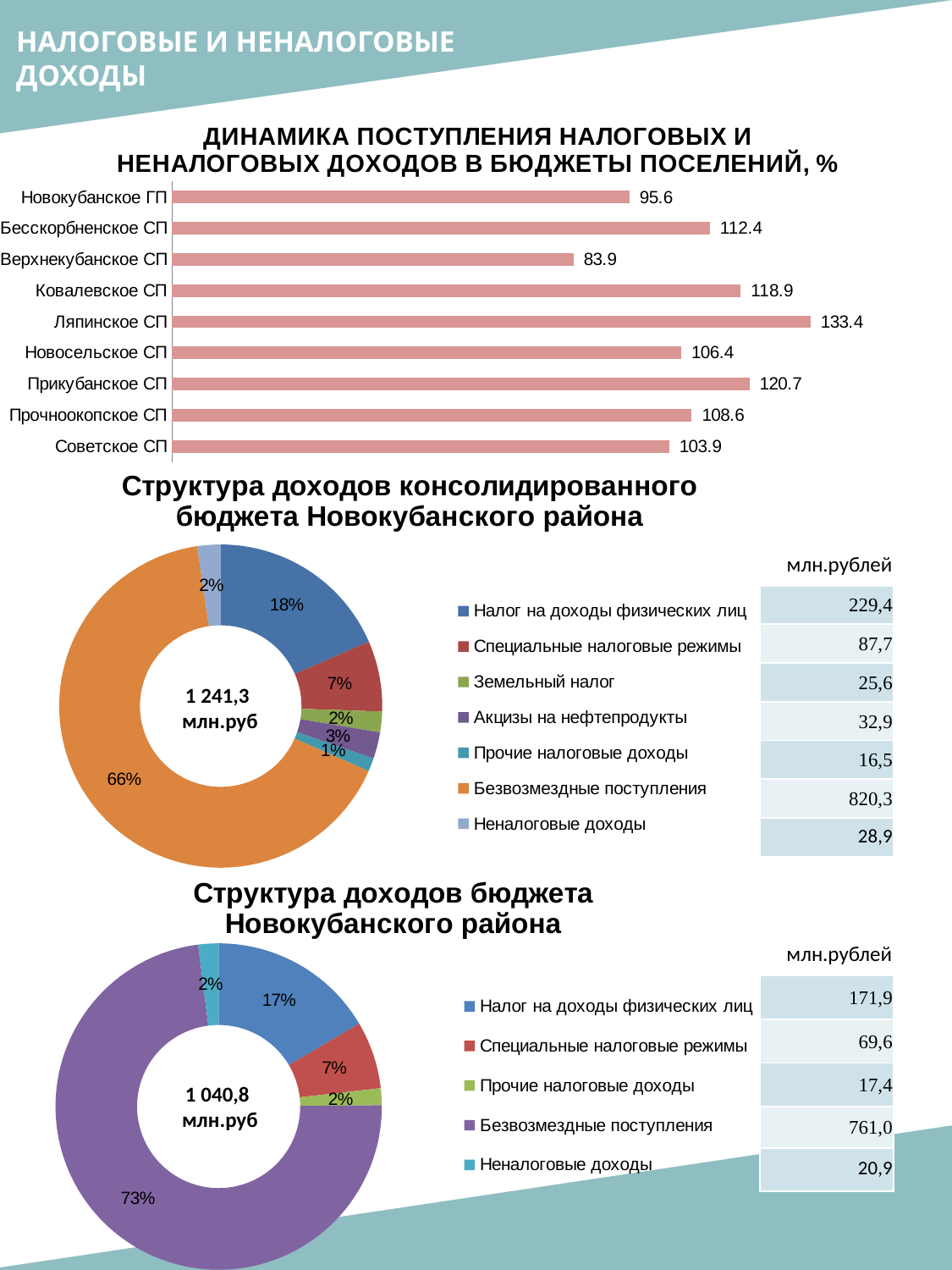
How many settlements are shown in the bar chart at the top of the slide? 9 In the bar chart at the top of the slide, which settlement has the highest value? Ляпинское СП In the bar chart at the top of the slide, what is the difference between the values for Ляпинское СП and Верхнекубанское СП? 49.5 In the bar chart at the top of the slide, which is larger: the value for Прикубанское СП or the value for Бесскорбненское СП? Прикубанское СП In the chart 'Структура доходов бюджета Новокубанского района' at the bottom of the slide, what share does Безвозмездные поступления have? 73% In the chart 'Структура доходов бюджета Новокубанского района' at the bottom of the slide, what total is shown in the centre of the doughnut? 1 040,8 млн.руб How many entries does the legend list in the chart 'Структура доходов консолидированного бюджета Новокубанского района'? 7 What type of chart is the top chart on the slide? Bar chart In the chart 'Структура доходов консолидированного бюджета Новокубанского района', what is the value in млн.рублей for Налог на доходы физических лиц? 229,4 In the bar chart 'Динамика поступления налоговых и неналоговых доходов в бюджеты поселений, %', what is the value for Ляпинское СП? 133.4 In the bar chart at the top of the slide, which settlement has the lowest value? Верхнекубанское СП In the chart 'Структура доходов консолидированного бюджета Новокубанского района', what share does Безвозмездные поступления have? 66%